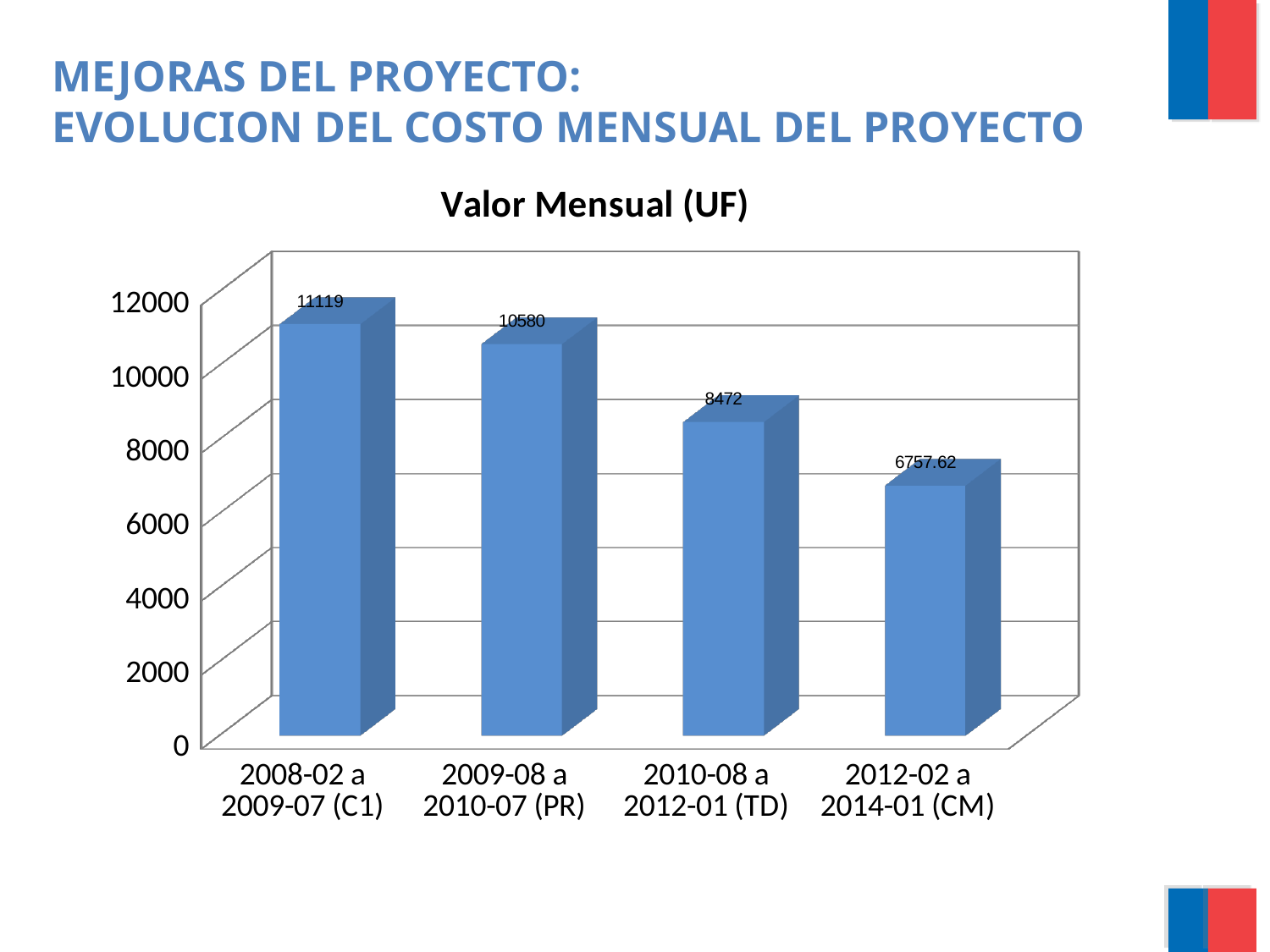
Do the values rise or fall from left to right across the periods? Fall Which period has the lowest value? 2012-02 a 2014-01 (CM) How many periods are shown on the chart? 4 Which is larger, the value for 2010-08 a 2012-01 (TD) or 2012-02 a 2014-01 (CM)? 2010-08 a 2012-01 (TD) What is the value for 2012-02 a 2014-01 (CM)? 6757.62 What is the value for 2008-02 a 2009-07 (C1)? 11119 Which period has the highest value? 2008-02 a 2009-07 (C1) What is the difference between the values for 2008-02 a 2009-07 (C1) and 2009-08 a 2010-07 (PR)? 539 What is the value for 2009-08 a 2010-07 (PR)? 10580 What is the difference between the values for 2009-08 a 2010-07 (PR) and 2010-08 a 2012-01 (TD)? 2108 What kind of chart is shown? Bar chart What is the value for 2010-08 a 2012-01 (TD)? 8472